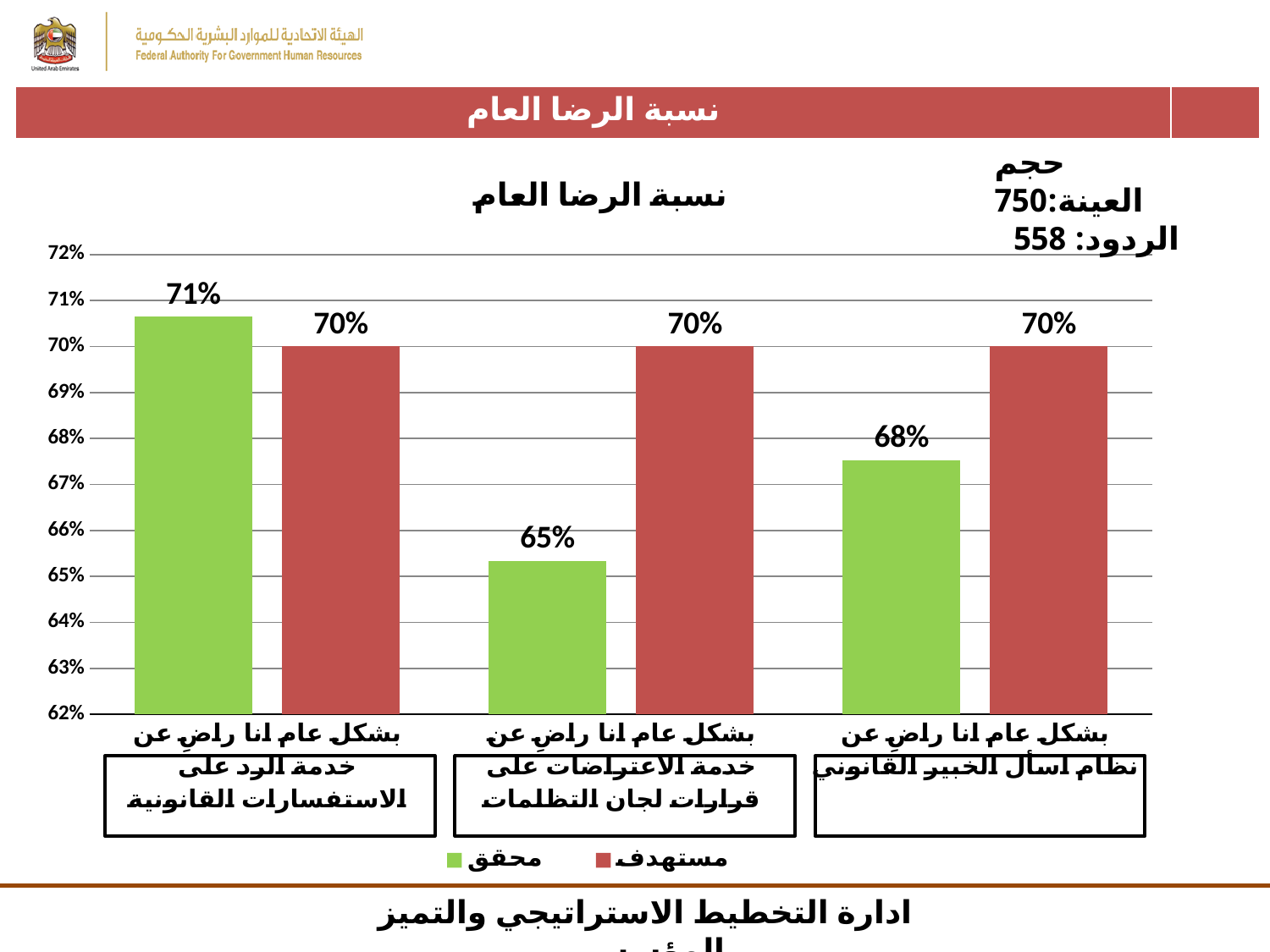
Which category has the highest achieved (محقق) value? خدمة الرد على الاستفسارات القانونية (the leftmost category) What is the achieved (محقق) value for the middle category (خدمة الاعتراضات على قرارات لجان التظلمات)? 65% How many categories are shown on the x axis of the chart? 3 Which category has the lowest achieved (محقق) value? خدمة الاعتراضات على قرارات لجان التظلمات (the middle category) What is the achieved (محقق) value for the first category on the left (خدمة الرد على الاستفسارات القانونية)? 71% How many series does the chart legend list? 2 By how many percentage points does the target exceed the achieved value for the middle category? 5 percentage points For the leftmost category, which is larger: the achieved (محقق) value or the target (مستهدف) value? achieved (محقق) What is the target (مستهدف) value for the middle category? 70% What is the achieved (محقق) value for the rightmost category (نظام اسأل الخبير القانوني)? 68% What are the two legend entries of the chart? محقق and مستهدف What kind of chart is shown on the slide? bar chart